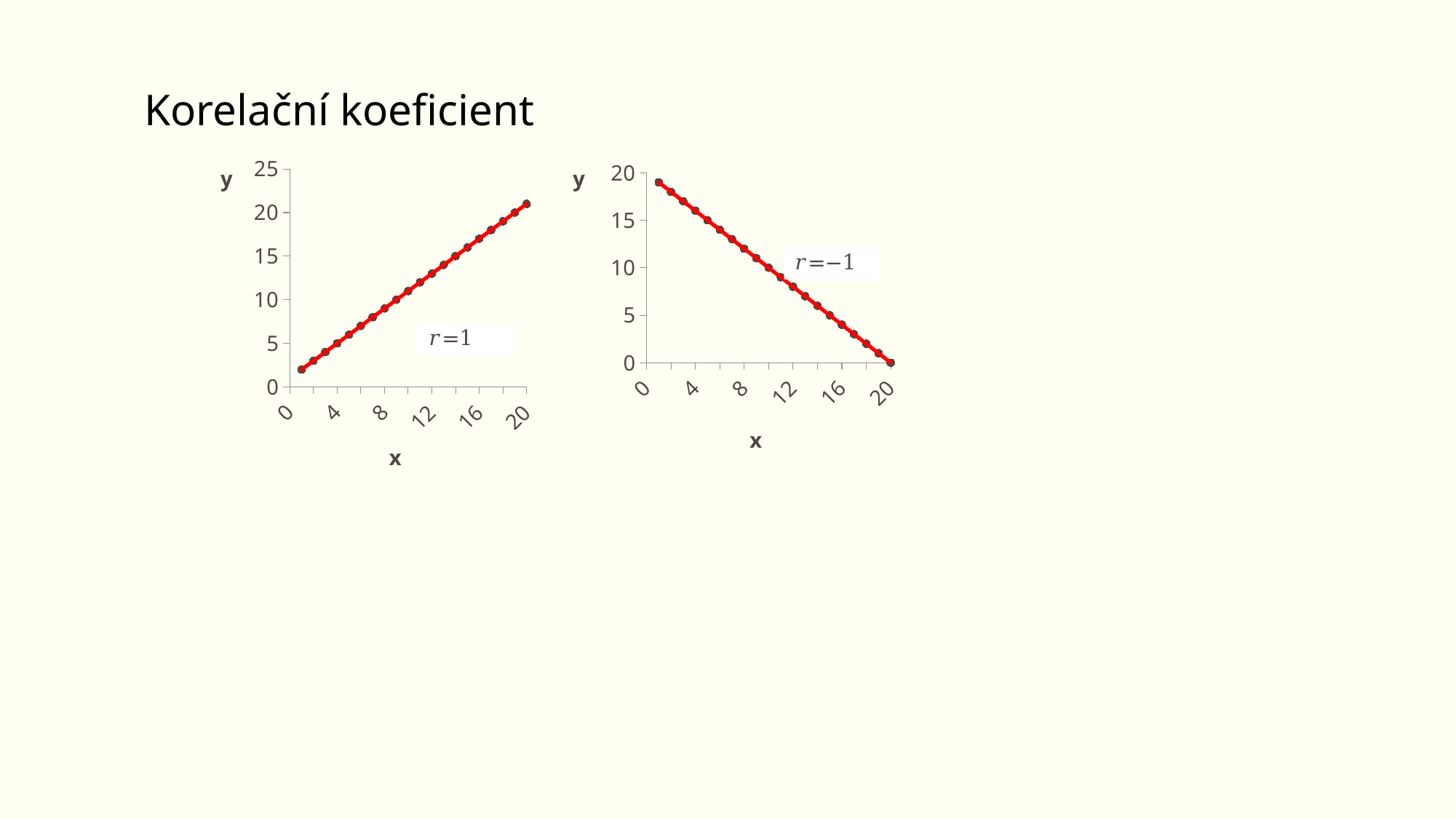
In the right chart (r=−1), is the y value at x=12 greater or less than 10? less In the left chart (r=1), is the y value at x=12 greater or less than 10? greater What kind of chart is the left chart (r=1)? scatter chart In the left chart (r=1), do the y values rise or fall as x increases? rise In the right chart (r=−1), is the y value at x=8 greater or less than 10? greater What correlation coefficient is annotated on the right chart? r=−1 What correlation coefficient is annotated on the left chart? r=1 In the right chart (r=−1), what is the y value of the last point, at x=20? 0 What kind of chart is the right chart (r=−1)? scatter chart How many charts are shown on the slide? 2 In the right chart (r=−1), do the y values rise or fall as x increases? fall